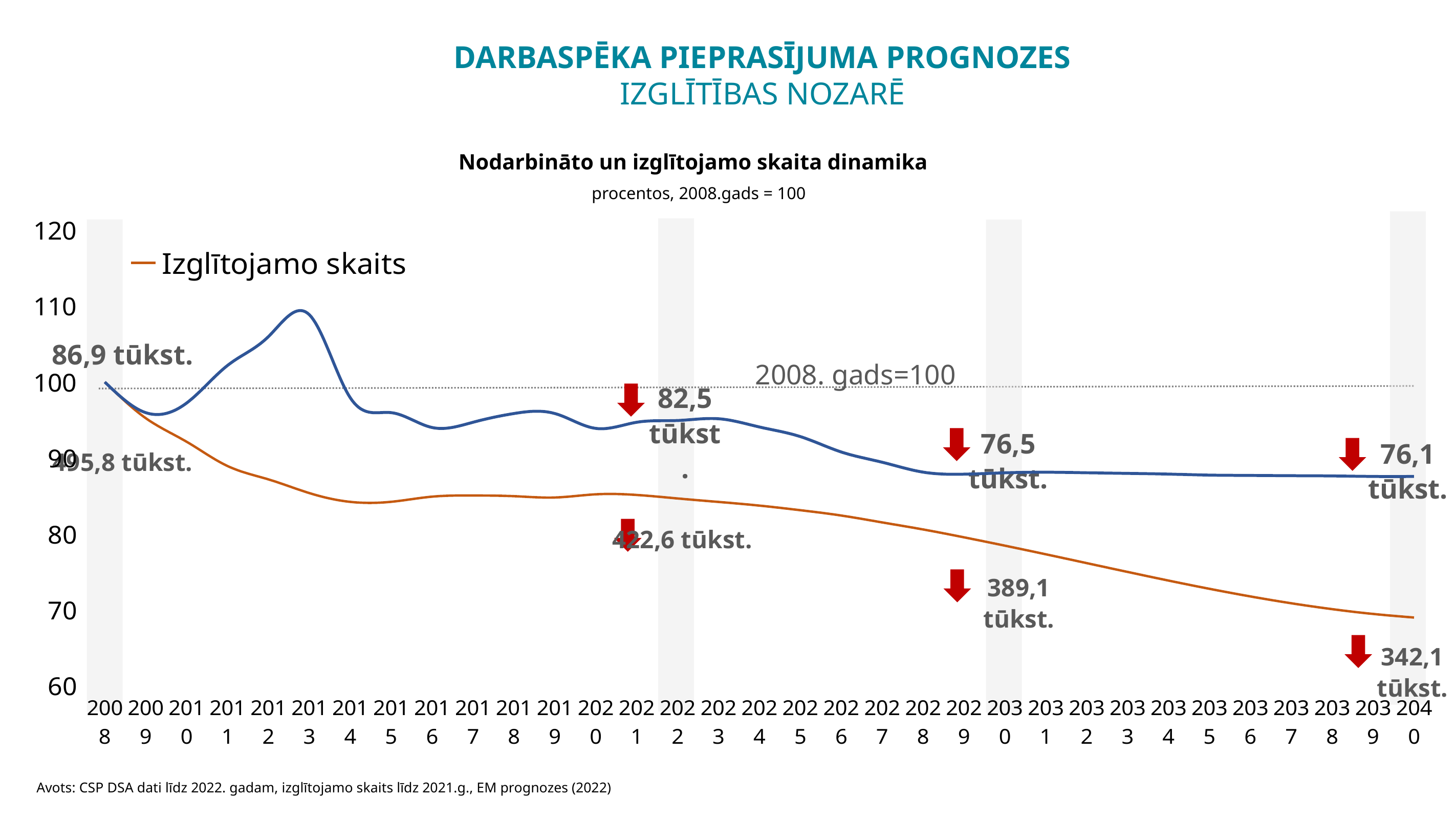
Which annotated blue-line value is larger: 2021 or 2029? 2021 Which series name is shown in the chart legend? Izglītojamo skaits What is the title of the chart? Nodarbināto un izglītojamo skaita dinamika By how many thousands does the annotated blue-line value fall from 2008 (86,9 tūkst.) to 2040 (76,1 tūkst.)? 10,8 tūkst. By how many thousands does the annotated Izglītojamo skaits value fall from 2021 (422,6 tūkst.) to 2040 (342,1 tūkst.)? 80,5 tūkst. Is the index value of the orange Izglītojamo skaits line in 2040 greater or less than 70? less What value in thousands is annotated on the blue line for 2008? 86,9 tūkst. What value in thousands is annotated on the orange Izglītojamo skaits line for 2029? 389,1 tūkst. What value in thousands is annotated on the blue line for 2040? 76,1 tūkst. What kind of chart is shown on the slide? line chart Does the orange Izglītojamo skaits line generally rise or fall from 2021 to 2040? fall What value in thousands is annotated on the orange Izglītojamo skaits line for 2040? 342,1 tūkst.